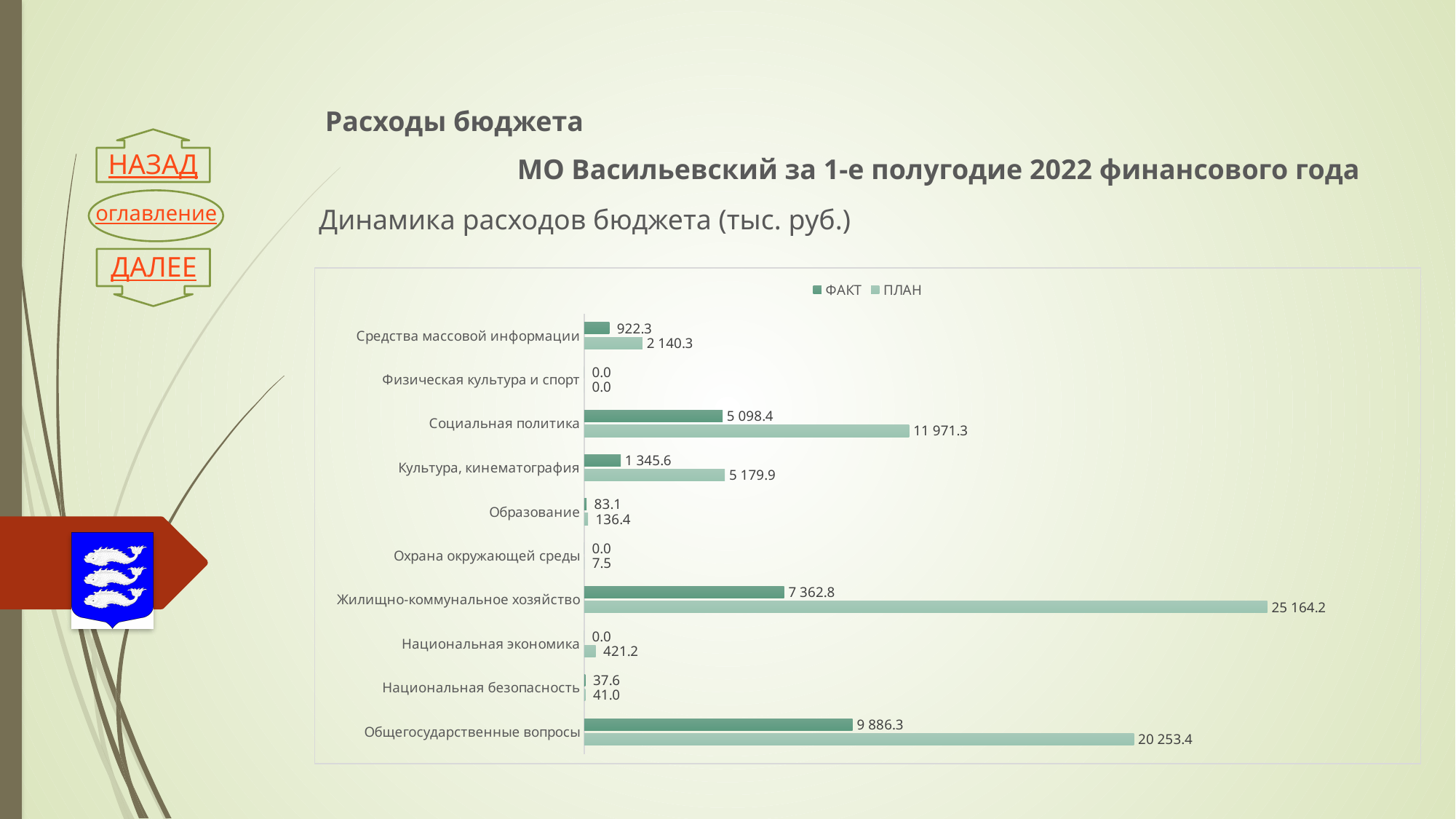
Which category has the highest ПЛАН value? Жилищно-коммунальное хозяйство What is the ПЛАН value for Жилищно-коммунальное хозяйство? 25 164.2 What kind of chart is shown on the slide? Bar chart What is the difference between the ПЛАН and ФАКТ values for Культура, кинематография? 3 834.3 Which has the larger ФАКТ value: Социальная политика or Жилищно-коммунальное хозяйство? Жилищно-коммунальное хозяйство What is the ФАКТ value for Средства массовой информации? 922.3 What is the ПЛАН value for Образование? 136.4 Which category has the highest ФАКТ value? Общегосударственные вопросы What is the difference between the ПЛАН and ФАКТ values for Общегосударственные вопросы? 10 367.1 How many series does the legend list? 2 What is the ФАКТ value for Социальная политика? 5 098.4 How many categories are shown on the chart? 10